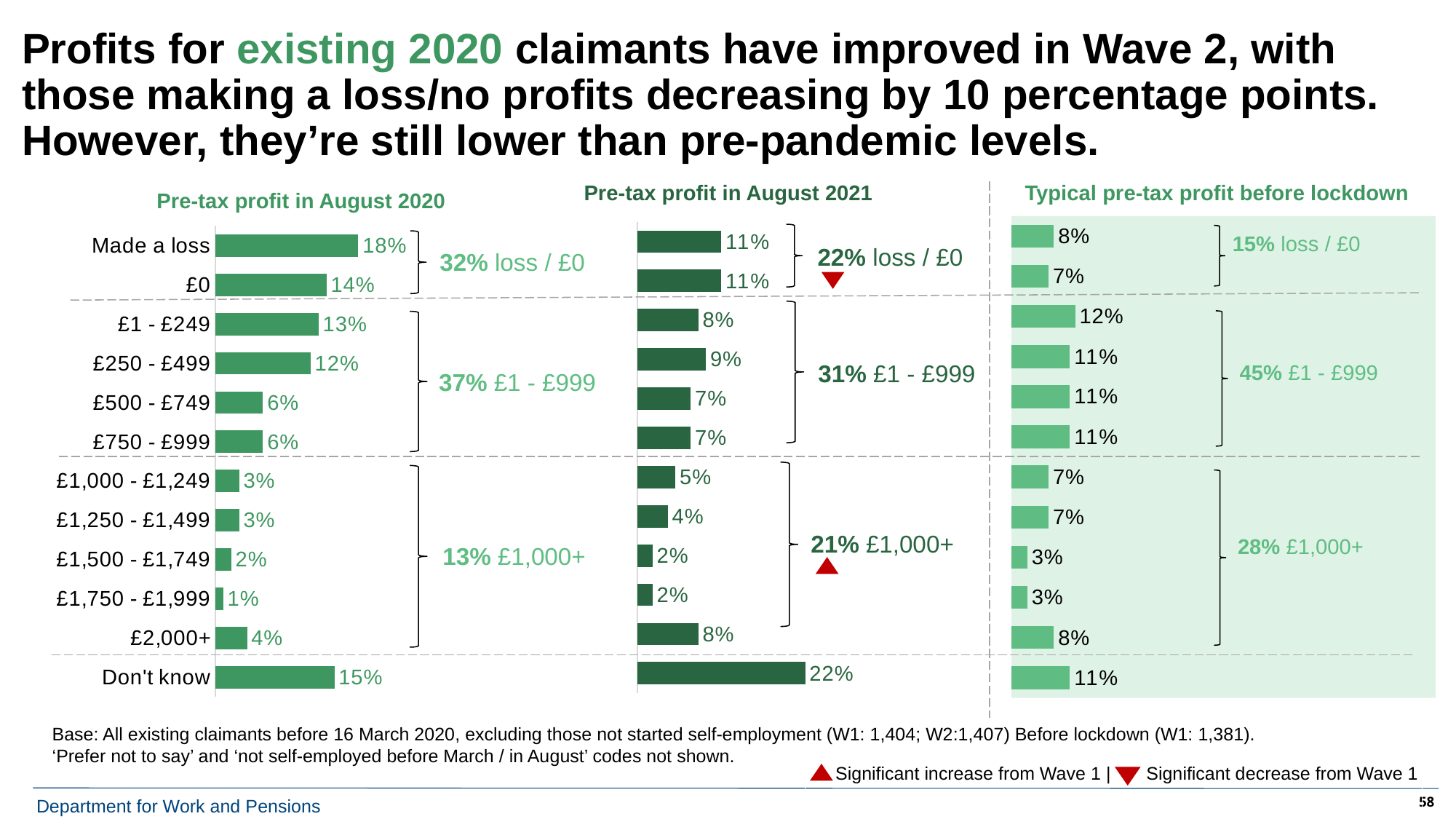
In the 'Pre-tax profit in August 2021' chart, which category has the highest value? Don't know In the 'Typical pre-tax profit before lockdown' chart, what is the difference between '£2,000+' and '£1,500 - £1,749'? 5 percentage points What kind of chart is the 'Pre-tax profit in August 2021' chart? Bar chart How many categories are shown in the 'Pre-tax profit in August 2020' chart? 12 In the 'Pre-tax profit in August 2021' chart, what is the combined share for the '£1 - £999' group shown on the slide? 31% In the 'Pre-tax profit in August 2020' chart, which category has the lowest value? £1,750 - £1,999 In the 'Pre-tax profit in August 2020' chart, what is the value for 'Made a loss'? 18% In the 'Typical pre-tax profit before lockdown' chart, what is the value for '£1 - £249'? 12% In the 'Pre-tax profit in August 2020' chart, what is the difference between 'Made a loss' and '£0'? 4 percentage points In the 'Pre-tax profit in August 2021' chart, what is the value for 'Don't know'? 22% What does the red downward triangle in the 'Pre-tax profit in August 2021' chart indicate? Significant decrease from Wave 1 In the 'Pre-tax profit in August 2021' chart, which is larger: '£2,000+' or '£1,000 - £1,249'? £2,000+